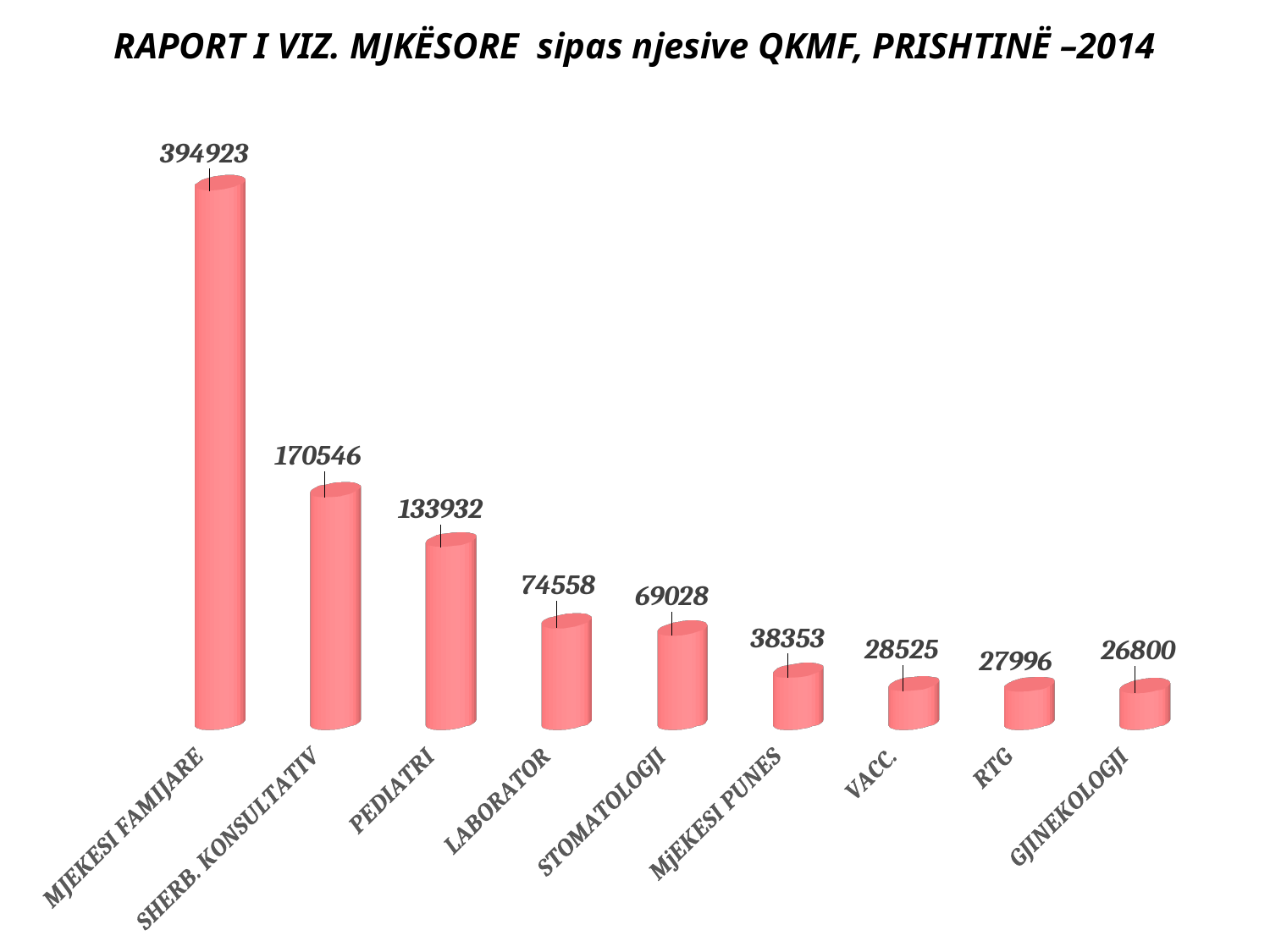
Do the values rise or fall from left to right along the x axis? fall What is the title of the chart? RAPORT I VIZ. MJKËSORE sipas njesive QKMF, PRISHTINË –2014 What is the value for VACC.? 28525 Which is larger, the value for MJEKESI PUNES or the value for RTG? MJEKESI PUNES Which category has the highest value? MJEKESI FAMIJARE What is the value for PEDIATRI? 133932 What is the value for MJEKESI FAMIJARE? 394923 What is the difference between the values for SHERB. KONSULTATIV and PEDIATRI? 36614 How many categories are shown in the chart? 9 What is the difference between the values for LABORATOR and STOMATOLOGJI? 5530 Which category has the lowest value? GJINEKOLOGJI What kind of chart is shown on the slide? bar chart